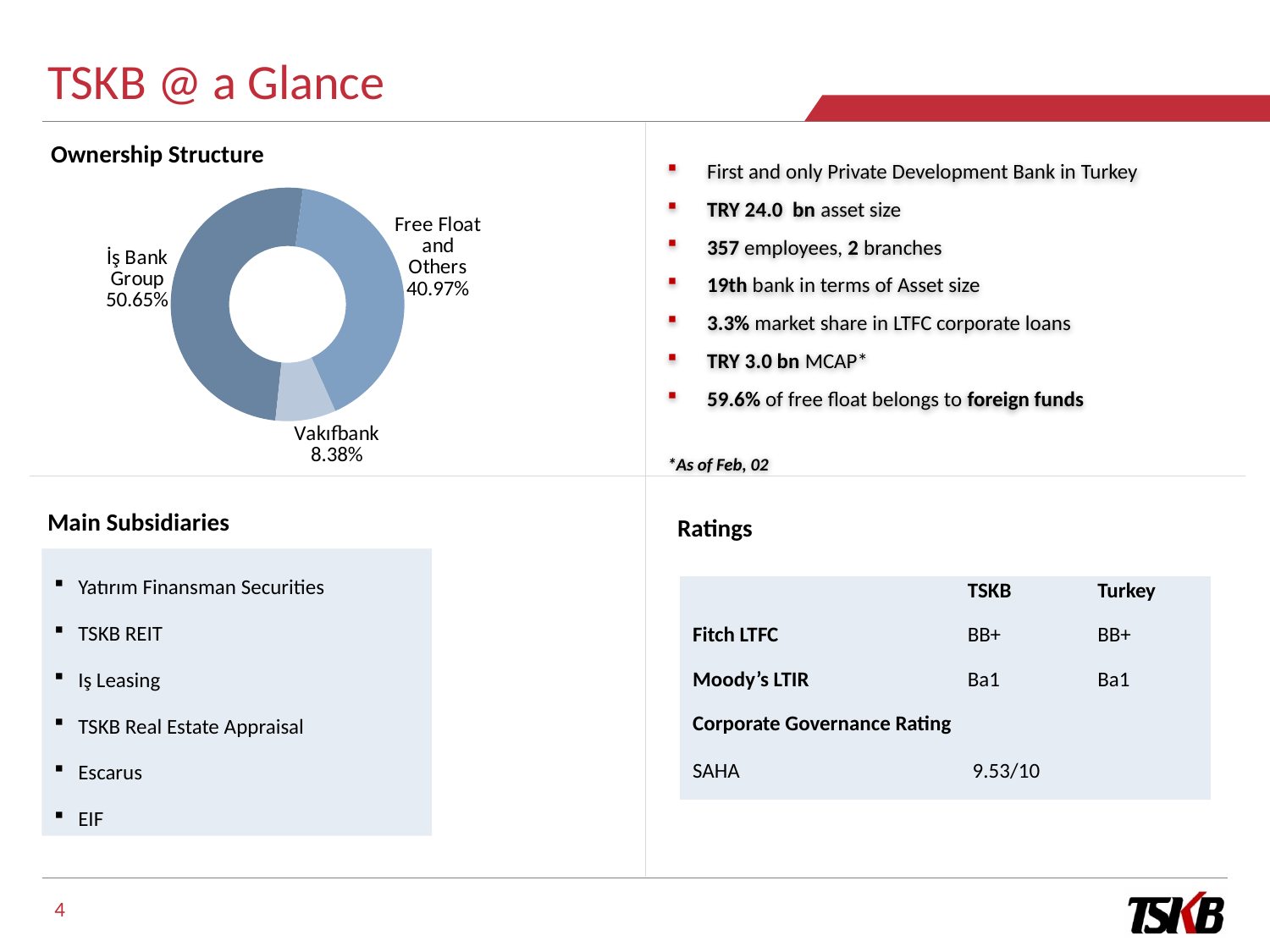
What share of ownership does Vakıfbank hold in the Ownership Structure chart? 8.38% Is the İş Bank Group share in the Ownership Structure chart greater or less than 50%? greater Which shareholder has the largest share in the Ownership Structure chart? İş Bank Group What type of chart is used to show the Ownership Structure? Doughnut (pie) chart What is the difference between the Free Float and Others share and the Vakıfbank share in the Ownership Structure chart? 32.59% Which is larger in the Ownership Structure chart: the İş Bank Group share or the Vakıfbank share? İş Bank Group What is the title of the chart on the slide? Ownership Structure What share of ownership is held by Free Float and Others in the Ownership Structure chart? 40.97% Which shareholder has the smallest share in the Ownership Structure chart? Vakıfbank What share of ownership does İş Bank Group hold in the Ownership Structure chart? 50.65% How many shareholder categories are shown in the Ownership Structure chart? 3 What is the difference between the İş Bank Group share and the Free Float and Others share in the Ownership Structure chart? 9.68%